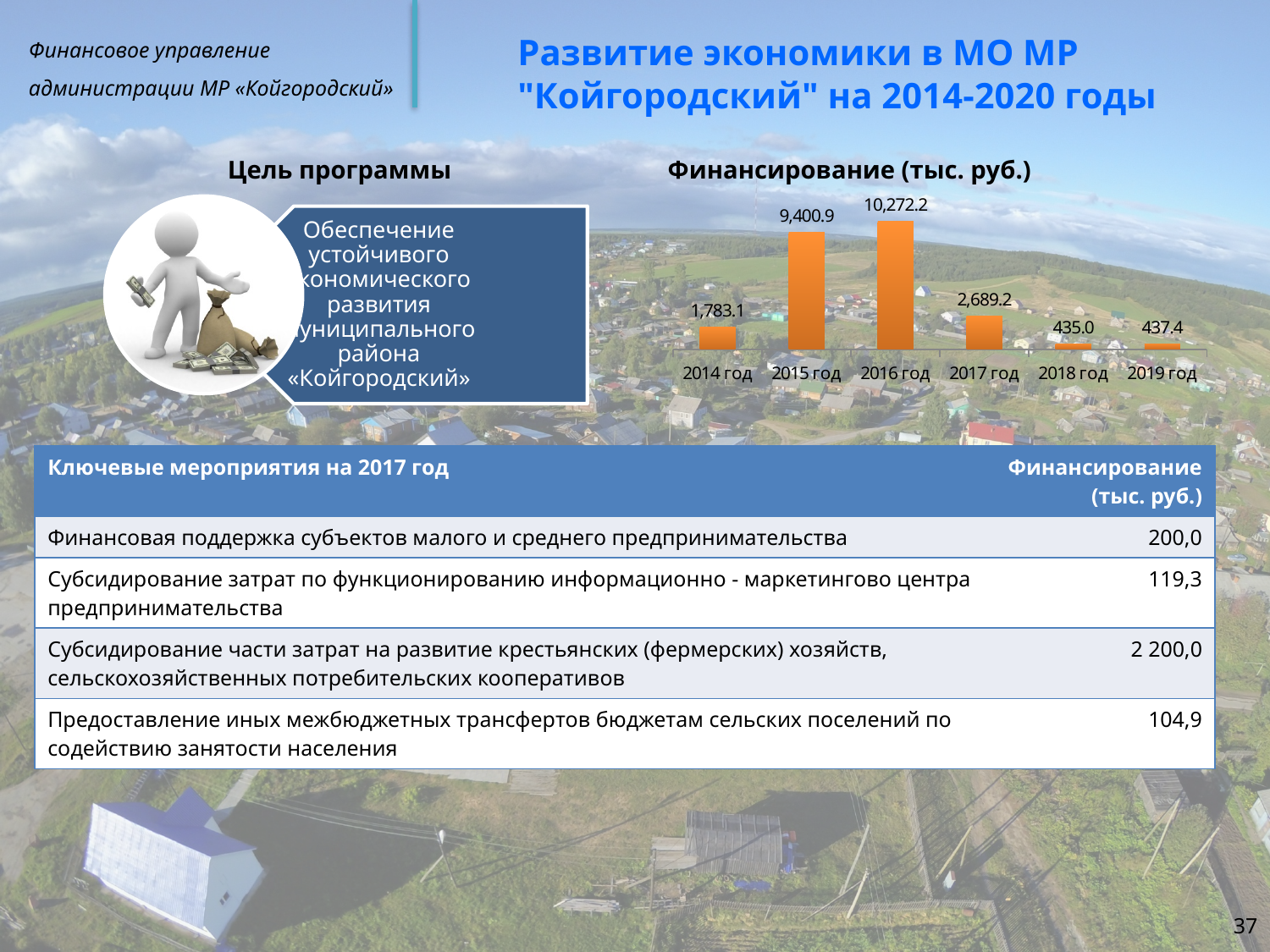
What is the value for 2014 год in the Финансирование (тыс. руб.) chart? 1,783.1 Which year has the highest value in the Финансирование (тыс. руб.) chart? 2016 год Which is larger in the Финансирование (тыс. руб.) chart, the value for 2017 год or the value for 2014 год? 2017 год What is the difference between the values for 2017 год and 2014 год in the Финансирование (тыс. руб.) chart? 906.1 What is the value for 2019 год in the Финансирование (тыс. руб.) chart? 437.4 How many years are shown in the Финансирование (тыс. руб.) chart? 6 What is the title of the chart on the slide? Финансирование (тыс. руб.) What is the value for 2015 год in the Финансирование (тыс. руб.) chart? 9,400.9 What is the value for 2017 год in the Финансирование (тыс. руб.) chart? 2,689.2 What is the difference between the values for 2016 год and 2015 год in the Финансирование (тыс. руб.) chart? 871.3 What kind of chart is the Финансирование (тыс. руб.) chart? bar chart Do the values in the Финансирование (тыс. руб.) chart rise or fall from 2016 год to 2018 год? fall